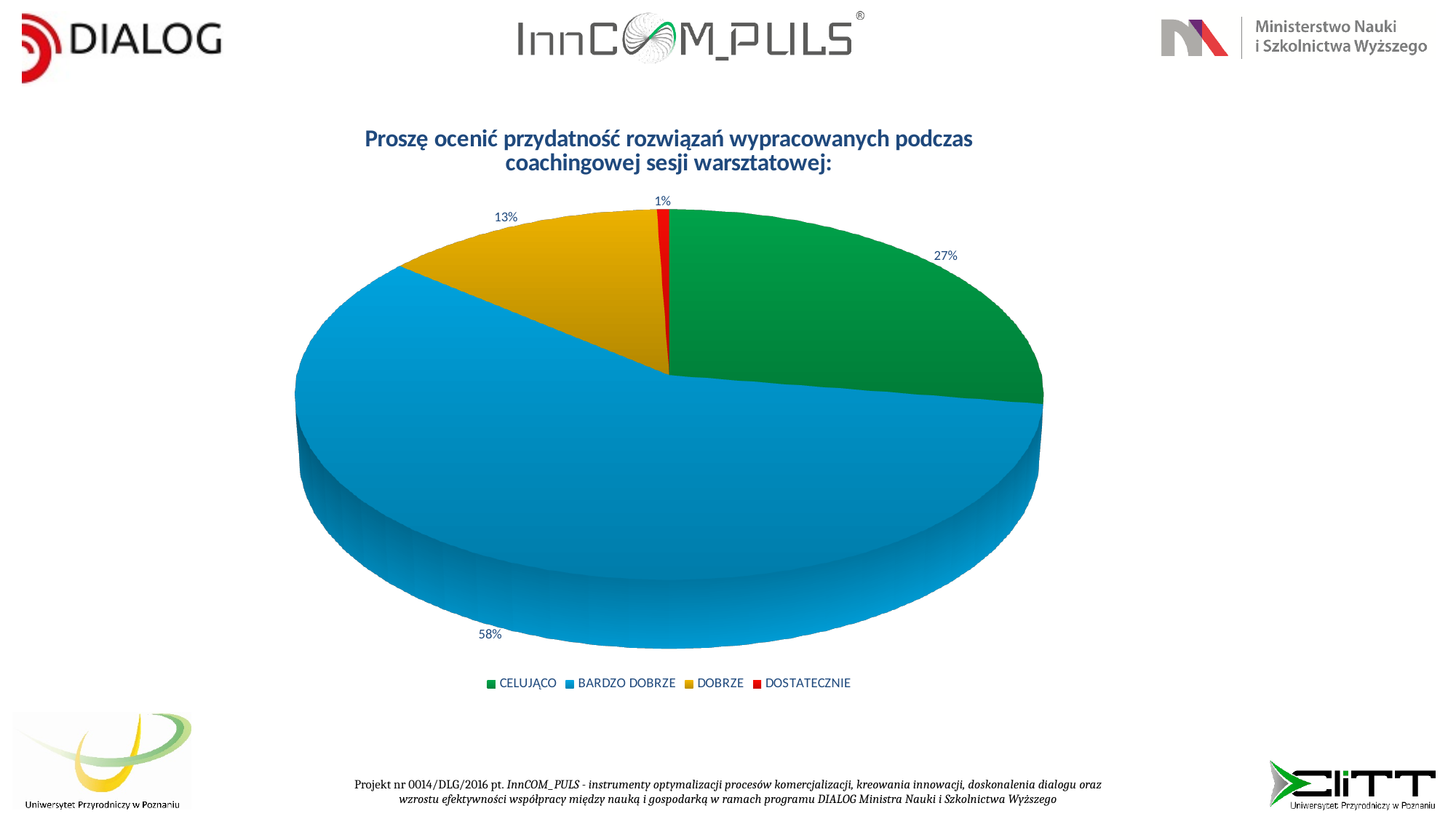
What share of the pie does BARDZO DOBRZE have? 58% What share of the pie does DOSTATECZNIE have? 1% What kind of chart is shown on the slide? pie chart Which category has the largest slice of the pie? BARDZO DOBRZE What share of the pie does DOBRZE have? 13% What is the title of the chart? Proszę ocenić przydatność rozwiązań wypracowanych podczas coachingowej sesji warsztatowej: What colour is the slice for DOBRZE? yellow How many categories does the pie chart show? 4 Which category has the smallest slice of the pie? DOSTATECZNIE What is the difference in percentage points between BARDZO DOBRZE and CELUJĄCO? 31 Which is larger, the share for CELUJĄCO or the share for DOBRZE? CELUJĄCO